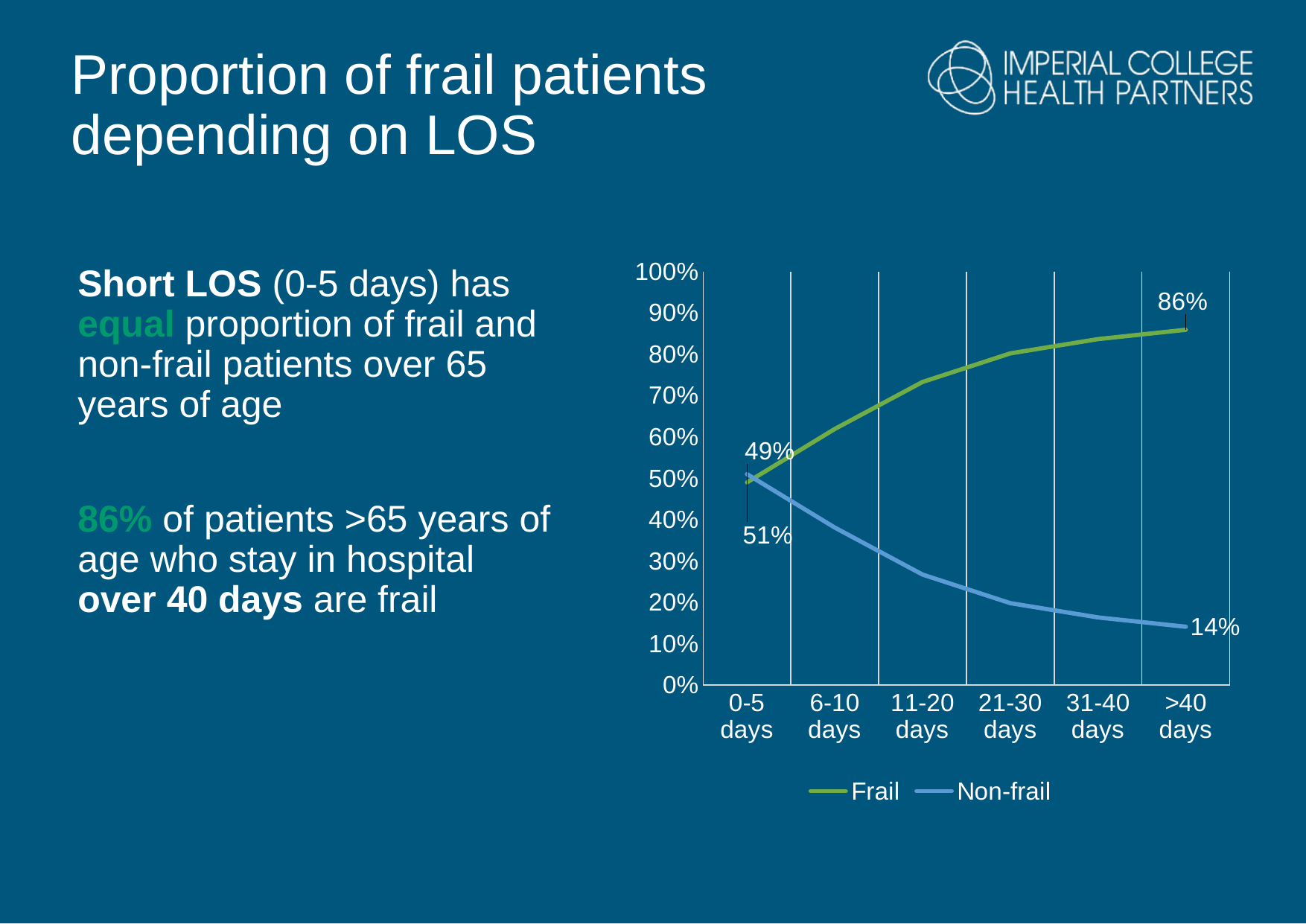
How many series does the chart legend list? 2 Which series is larger at 21-30 days, Frail or Non-frail? Frail Does the Frail series rise or fall as length of stay increases? Rises Does the Non-frail series rise or fall as length of stay increases? Falls What is the Non-frail value for >40 days? 14% What is the Non-frail value for 0-5 days? 51% What kind of chart is shown on the slide? Line chart What is the Frail value for 0-5 days? 49% What is the difference between the Frail and Non-frail values at >40 days? 72% What is the Frail value for >40 days? 86% Is the Frail value for 11-20 days greater or less than 60%? greater How many length-of-stay categories are shown on the x axis? 6